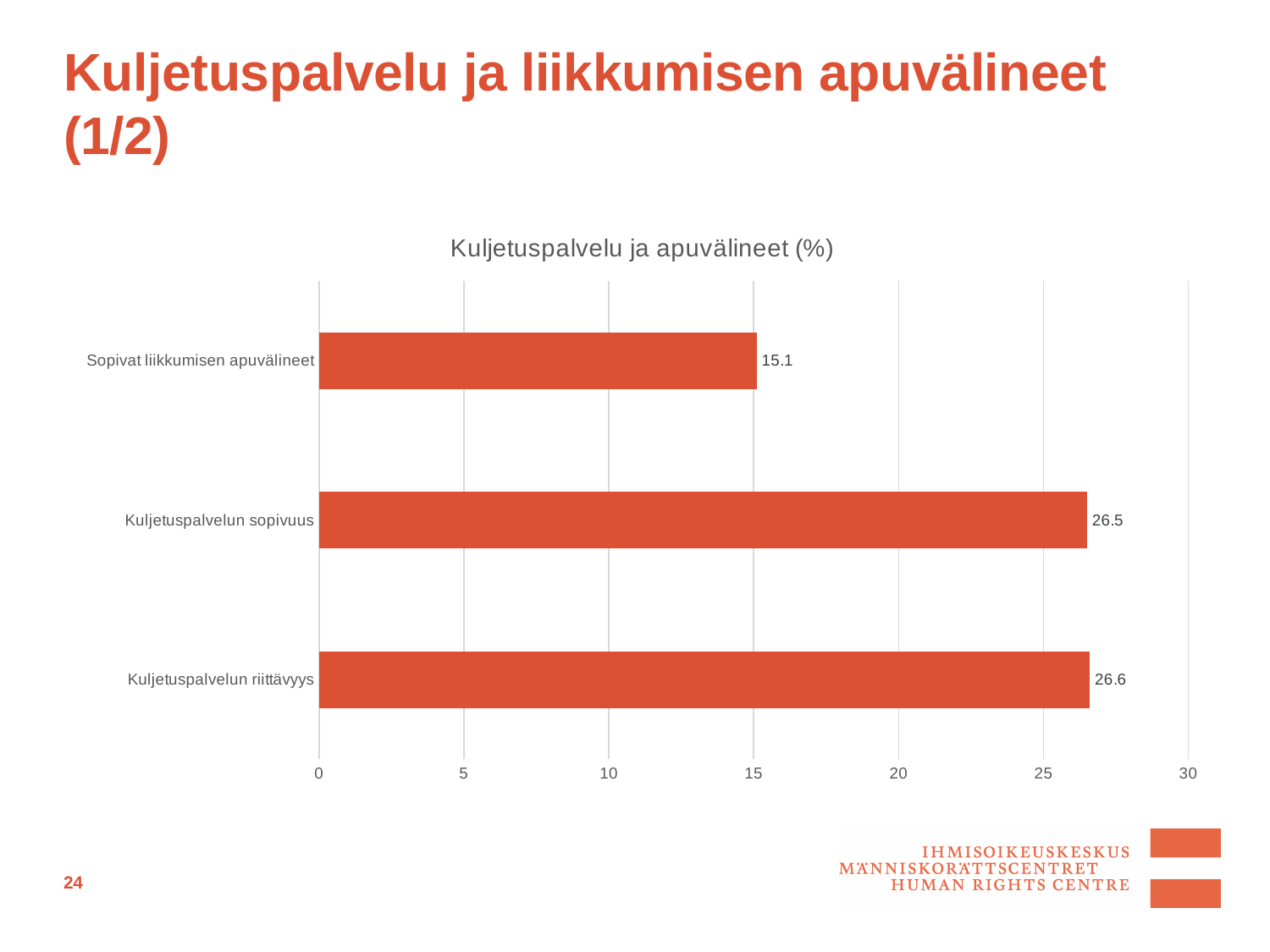
What is the title of the chart? Kuljetuspalvelu ja apuvälineet (%) What is the difference between the values for Kuljetuspalvelun riittävyys and Kuljetuspalvelun sopivuus? 0.1 Which category has the lowest value? Sopivat liikkumisen apuvälineet How many categories are shown in the chart? 3 What is the value for Kuljetuspalvelun riittävyys? 26.6 What kind of chart is shown on the slide? bar chart What is the value for Sopivat liikkumisen apuvälineet? 15.1 Is the value for Sopivat liikkumisen apuvälineet greater or less than 20? less Which is larger, the value for Kuljetuspalvelun sopivuus or the value for Sopivat liikkumisen apuvälineet? Kuljetuspalvelun sopivuus What is the difference between the values for Kuljetuspalvelun sopivuus and Sopivat liikkumisen apuvälineet? 11.4 What is the value for Kuljetuspalvelun sopivuus? 26.5 Which category has the highest value according to the data labels? Kuljetuspalvelun riittävyys